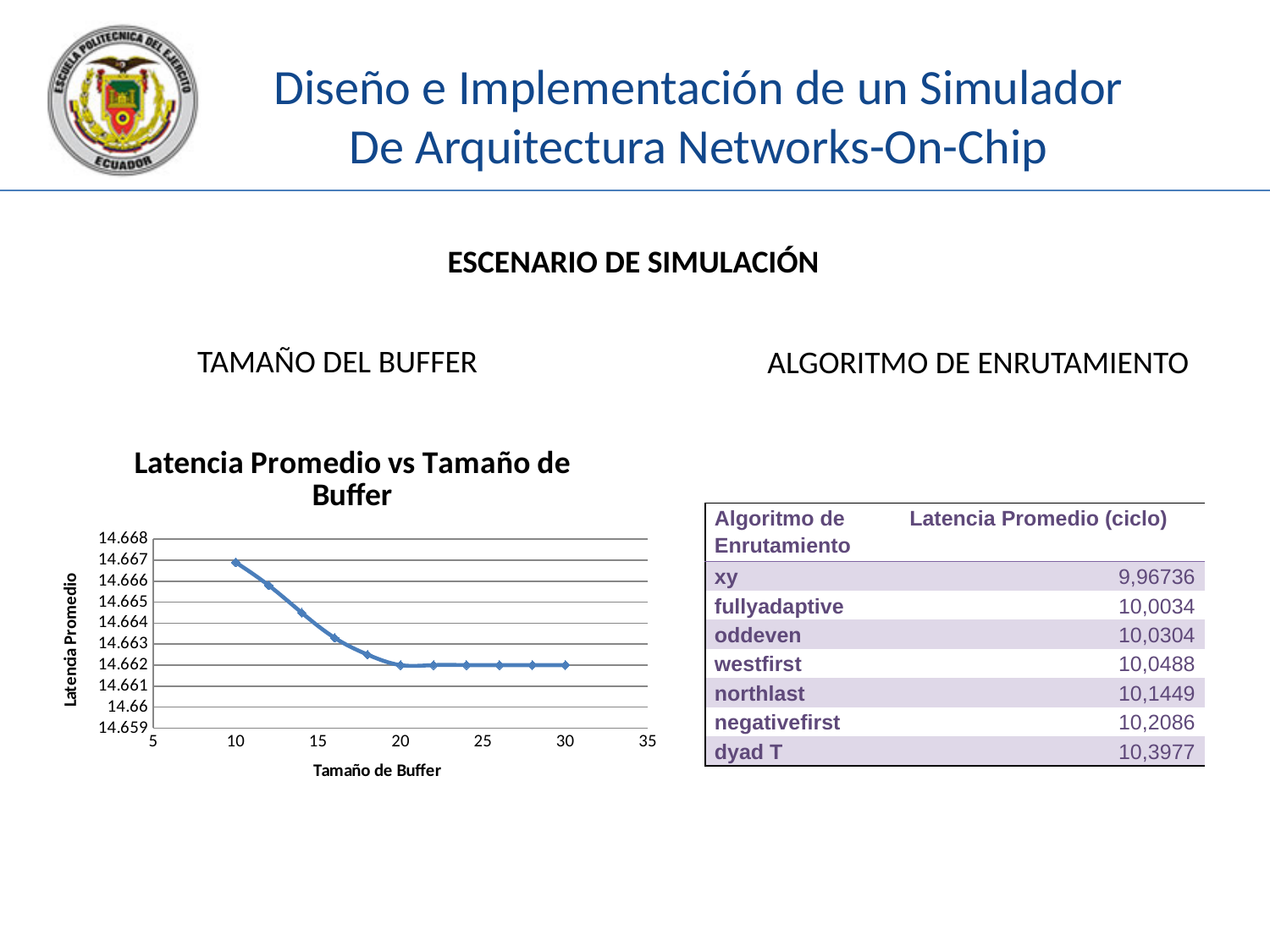
Which has the larger average latency in the chart, buffer size 12 or buffer size 20? buffer size 12 Is the value for buffer size 14 greater or less than 14.663? greater Do the values in the chart rise or fall as the buffer size increases from 10 to 20? fall How many data points are plotted on the line in the chart? 11 At which buffer size is the average latency highest in the chart? 10 What is the title of the chart on the slide? Latencia Promedio vs Tamaño de Buffer Is the value for buffer size 30 greater or less than 14.664? less What kind of chart is shown on the slide? line chart Which has the larger average latency in the chart, buffer size 10 or buffer size 30? buffer size 10 Is the value for buffer size 10 greater or less than 14.665? greater What is the label of the x axis of the chart? Tamaño de Buffer